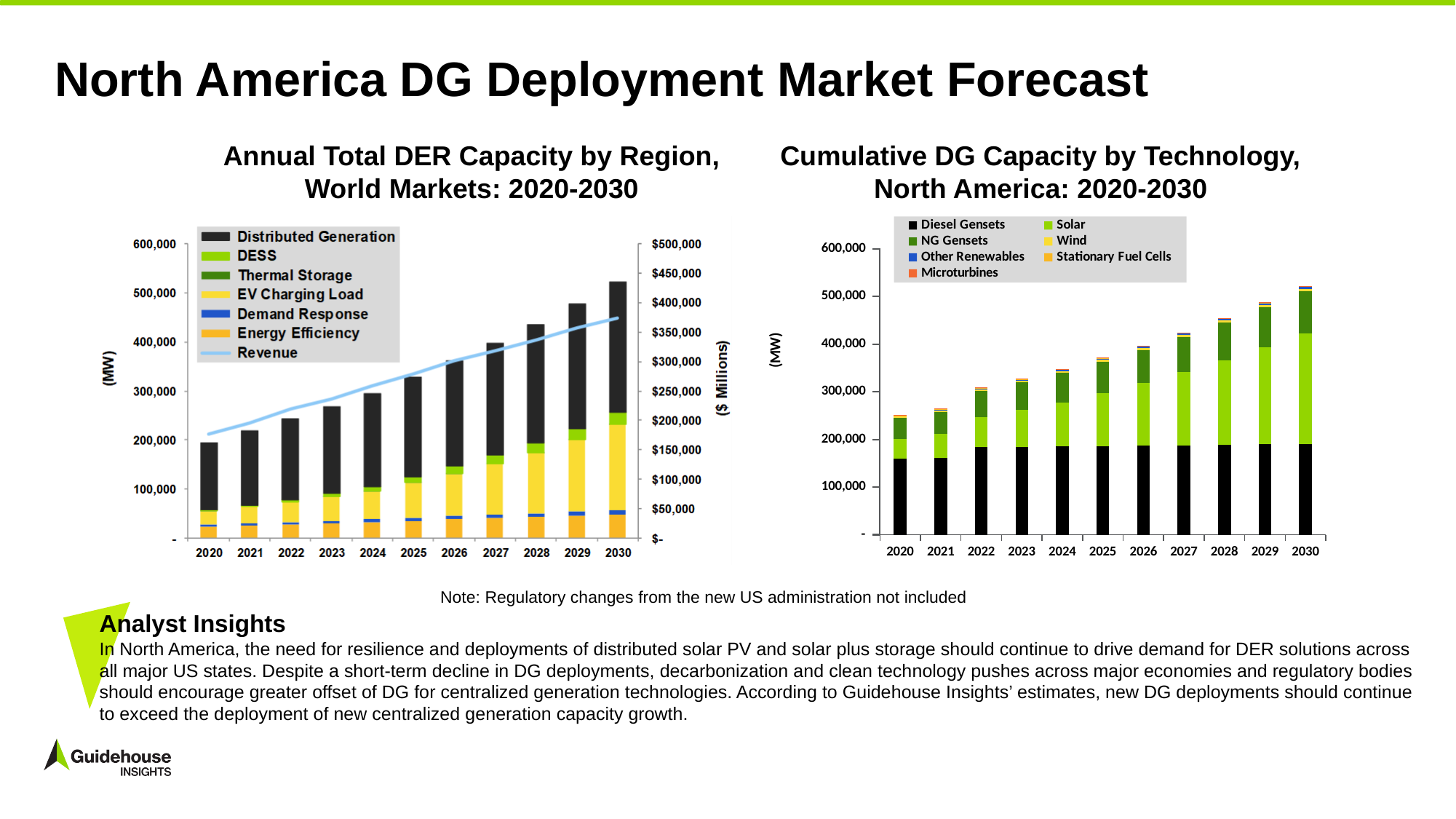
In the 'Annual Total DER Capacity by Region, World Markets: 2020-2030' chart, which year has the shortest stacked bar? 2020 In the 'Cumulative DG Capacity by Technology, North America: 2020-2030' chart, is the total stacked bar for 2030 larger or smaller than the total for 2020? larger In the 'Annual Total DER Capacity by Region, World Markets: 2020-2030' chart, what unit is shown on the right-hand axis? $ Millions In the 'Annual Total DER Capacity by Region, World Markets: 2020-2030' chart, is the total stacked bar for 2030 greater or less than 500,000 MW? greater In the 'Cumulative DG Capacity by Technology, North America: 2020-2030' chart, how many series does the legend list? 7 In the 'Annual Total DER Capacity by Region, World Markets: 2020-2030' chart, which year has the tallest stacked bar? 2030 In the 'Cumulative DG Capacity by Technology, North America: 2020-2030' chart, which technology forms the largest segment of the 2020 bar? Diesel Gensets In the 'Cumulative DG Capacity by Technology, North America: 2020-2030' chart, what kind of chart is it? stacked bar chart In the 'Annual Total DER Capacity by Region, World Markets: 2020-2030' chart, how many series does the legend list? 7 In the 'Cumulative DG Capacity by Technology, North America: 2020-2030' chart, is the total stacked bar for 2020 greater or less than 200,000 MW? greater In the 'Annual Total DER Capacity by Region, World Markets: 2020-2030' chart, does the Revenue line rise or fall from 2020 to 2030? rise In the 'Annual Total DER Capacity by Region, World Markets: 2020-2030' chart, how many years are shown on the x axis? 11